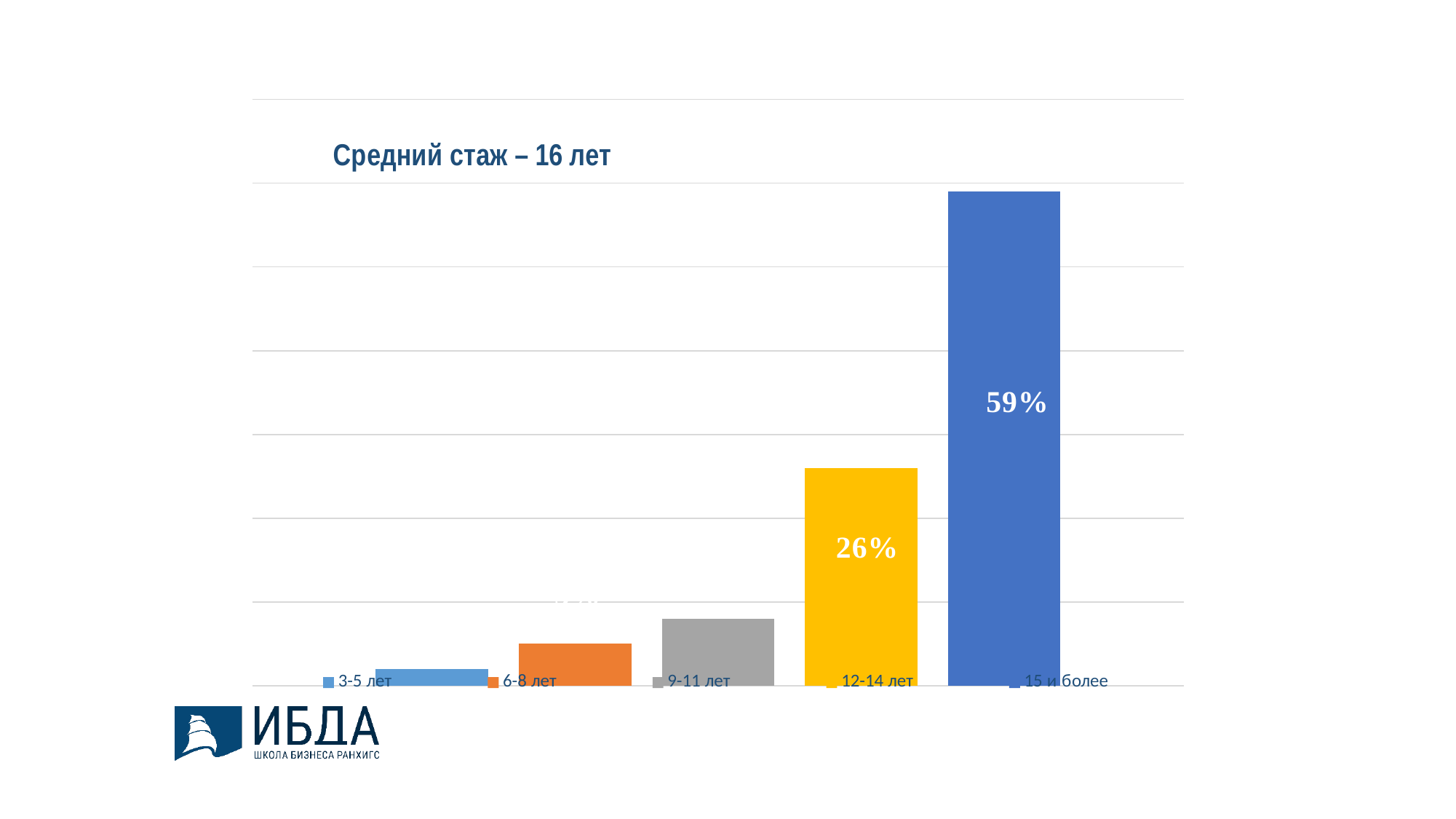
Which category has the lowest value? 3-5 лет What kind of chart is shown on the slide? Bar chart Which is larger, the value for '9-11 лет' or the value for '12-14 лет'? 12-14 лет What colour is the bar for '12-14 лет'? Yellow Which is larger, the value for '6-8 лет' or the value for '3-5 лет'? 6-8 лет What is the difference between the values for '15 и более' and '12-14 лет'? 33% What is the value for the '12-14 лет' category? 26% Do the values rise or fall from left to right across the categories? Rise What is the title of the chart? Средний стаж – 16 лет What is the value for the '15 и более' category? 59% Which category has the highest value? 15 и более How many categories are shown in the chart? 5